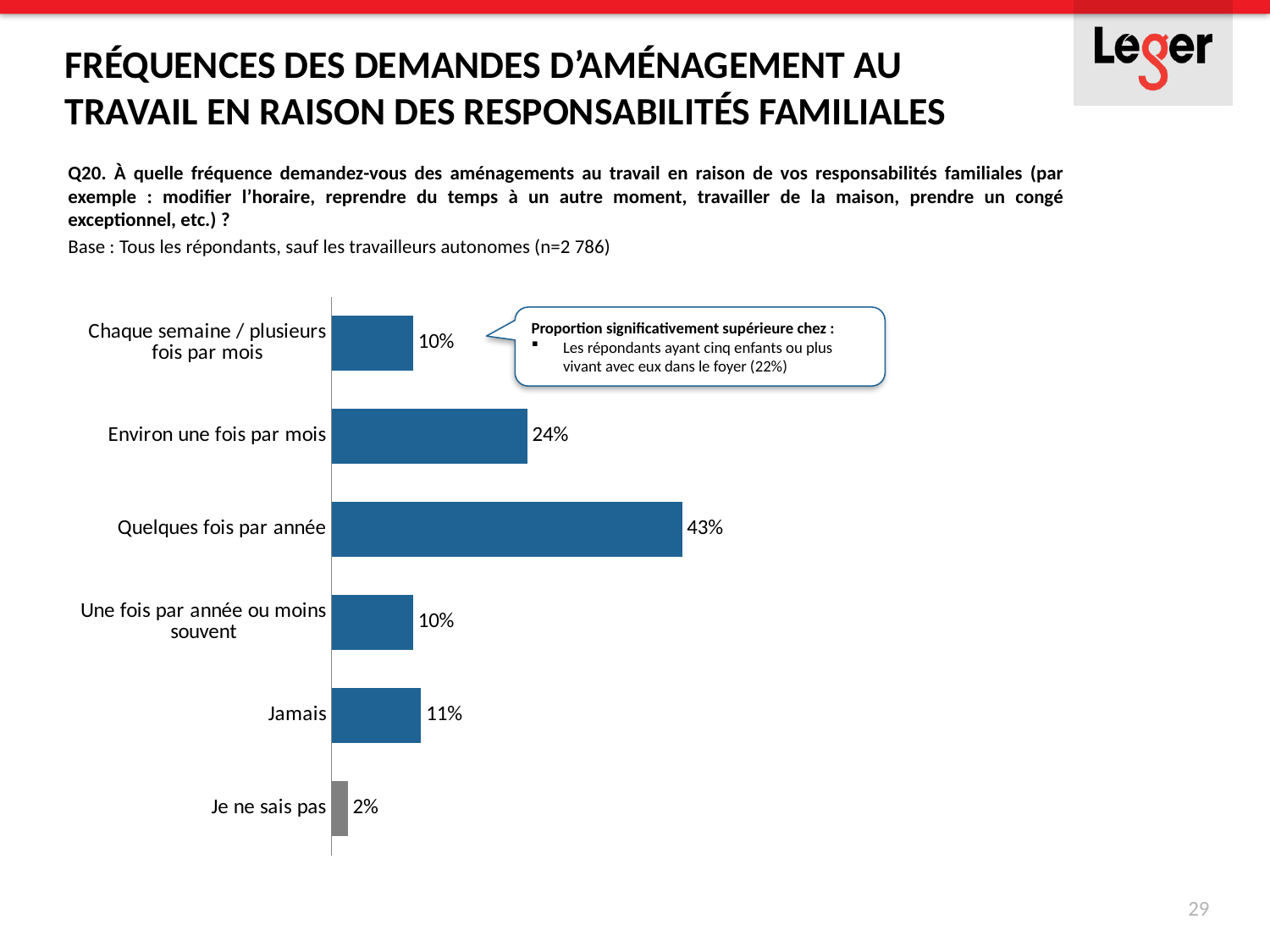
Which bar is coloured grey rather than blue? Je ne sais pas What is the value for "Je ne sais pas"? 2% Which category has the lowest value? Je ne sais pas What is the value for "Quelques fois par année"? 43% What kind of chart is shown on the slide? Bar chart What is the difference between "Quelques fois par année" and "Environ une fois par mois"? 19% Which is larger, "Jamais" or "Une fois par année ou moins souvent"? Jamais Which category has the highest value? Quelques fois par année What is the value for "Environ une fois par mois"? 24% How many categories are shown in the chart? 6 What is the difference between "Jamais" and "Je ne sais pas"? 9% What is the value for "Jamais"? 11%